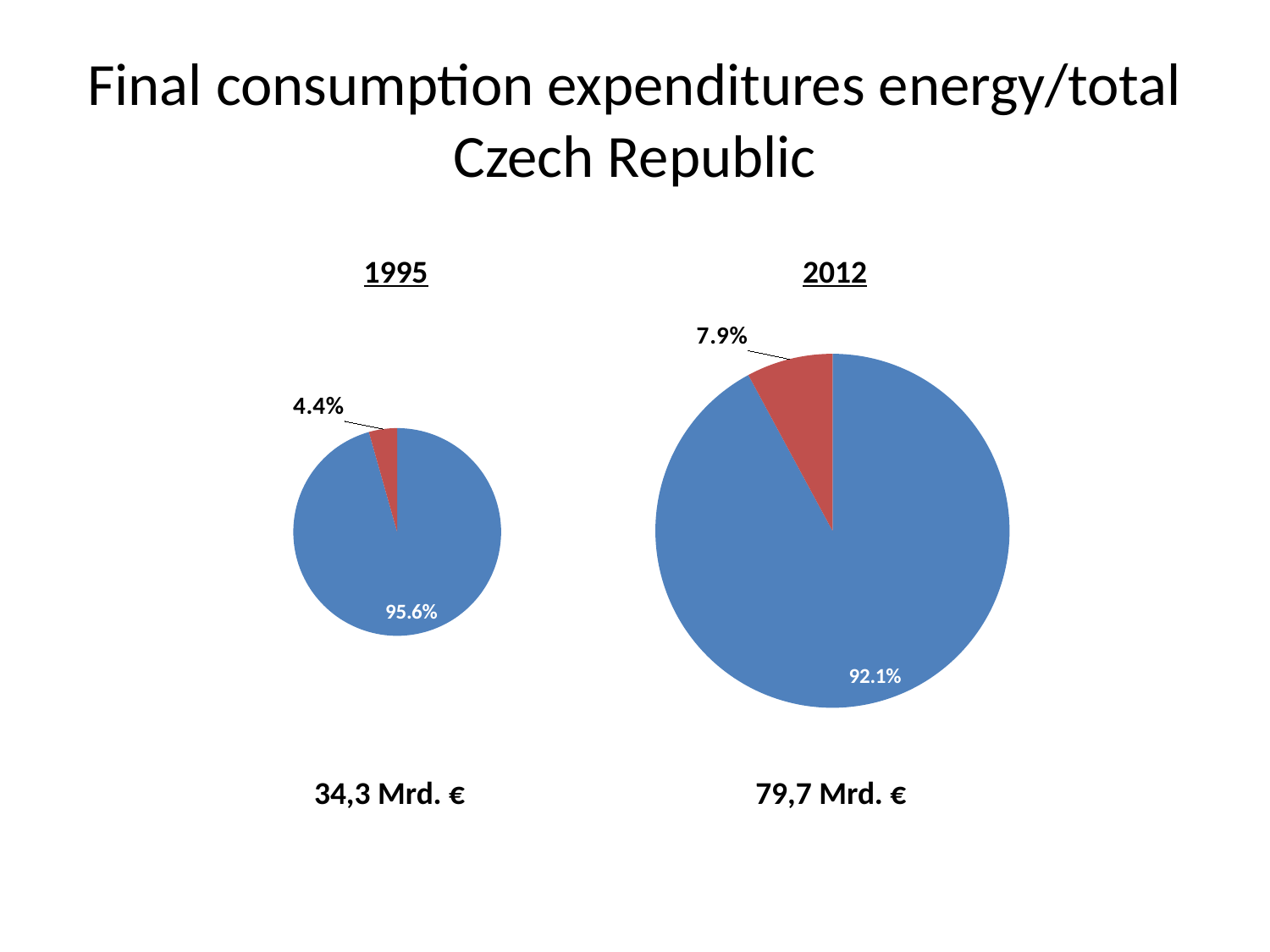
In the 1995 pie chart, what share does the blue slice have? 95.6% How many slices does each pie chart have? 2 Which pie chart has the larger red slice, 1995 or 2012? 2012 How many pie charts are on the slide? 2 What is the title of the slide? Final consumption expenditures energy/total Czech Republic In the 2012 pie chart, what share does the blue slice have? 92.1% By how many percentage points did the red slice's share grow from the 1995 pie chart to the 2012 pie chart? 3.5 What total amount is printed below the 2012 pie chart? 79,7 Mrd. € In the 2012 pie chart, what share does the red slice have? 7.9% What total amount is printed below the 1995 pie chart? 34,3 Mrd. € What kind of charts are shown on the slide? Pie charts